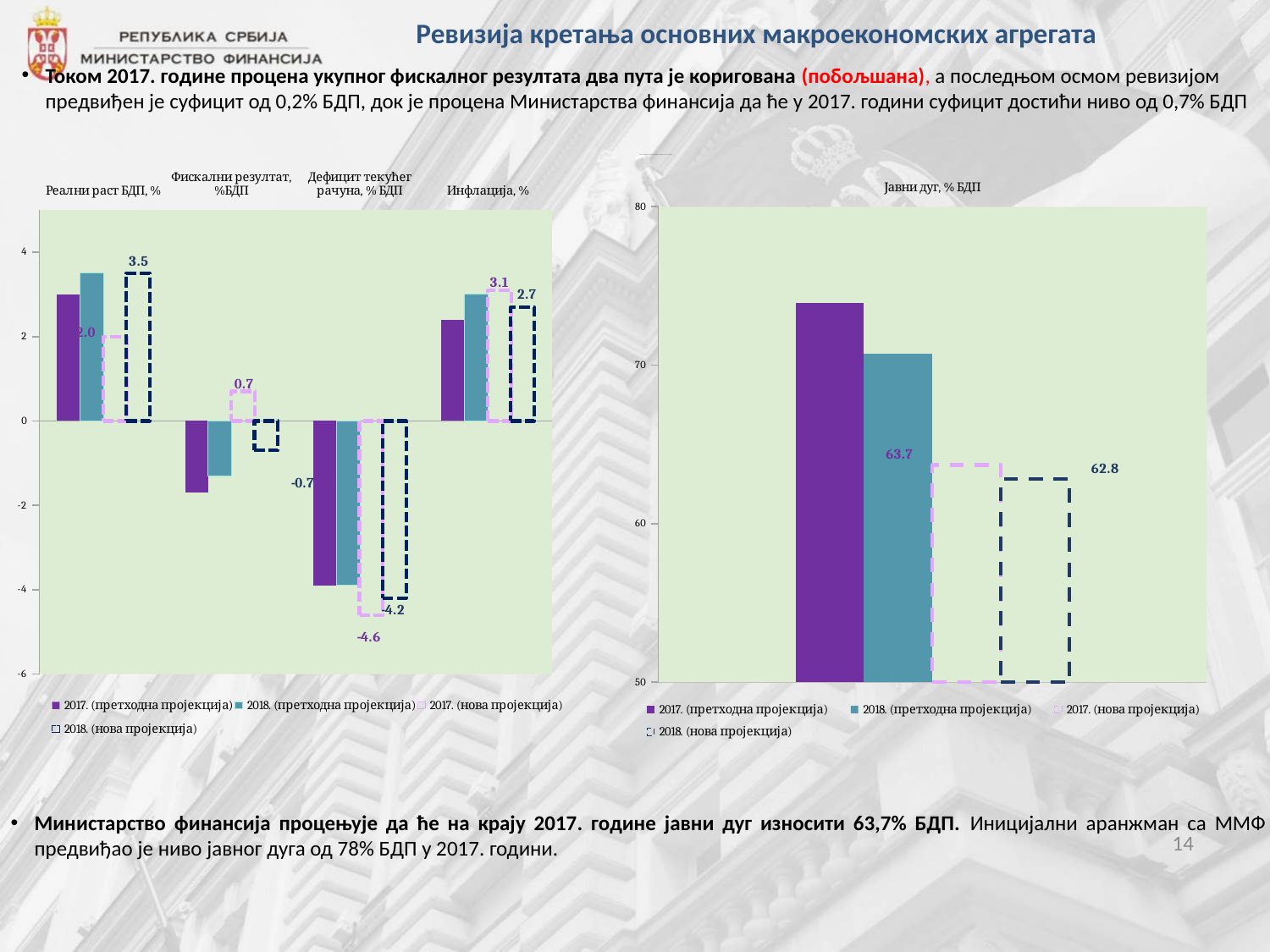
In the left chart, what is the value of 2017. (нова пројекција) for Фискални резултат, %БДП? 0.7 In the left chart, what is the value of 2018. (нова пројекција) for Реални раст БДП, %? 3.5 In the left chart, what is the value of 2017. (нова пројекција) for Инфлација, %? 3.1 In the chart titled 'Јавни дуг, % БДП', which series has the highest value? 2017. (претходна пројекција) In the left chart, for Инфлација, %, which is larger: 2017. (нова пројекција) or 2018. (нова пројекција)? 2017. (нова пројекција) In the left chart, what is the difference between the 2018. (нова пројекција) and 2017. (нова пројекција) values for Реални раст БДП, %? 1.5 In the chart titled 'Јавни дуг, % БДП', what is the value for 2018. (нова пројекција)? 62.8 What kind of chart is the left chart? bar chart In the chart titled 'Јавни дуг, % БДП', how many series does the legend list? 4 In the left chart, what is the value of 2017. (нова пројекција) for Дефицит текућег рачуна, % БДП? -4.6 In the chart titled 'Јавни дуг, % БДП', what is the value for 2017. (нова пројекција)? 63.7 In the chart titled 'Јавни дуг, % БДП', is the value for 2017. (претходна пројекција) greater or less than 70? greater